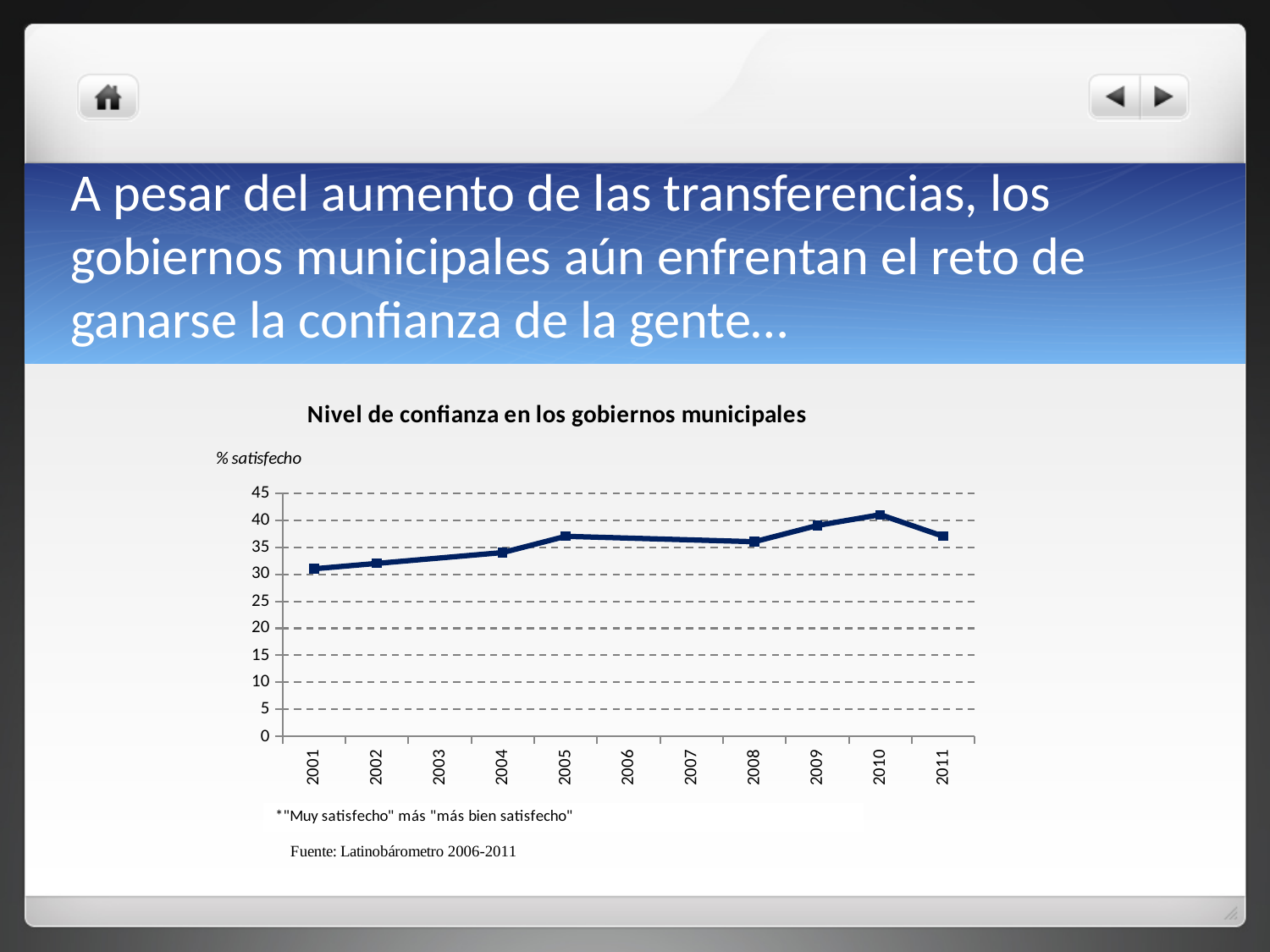
Is the value for 2001 greater or less than 35? less Is the value for 2009 greater or less than 35? greater What is the title of the chart? Nivel de confianza en los gobiernos municipales Which year has the larger value, 2010 or 2011? 2010 In which year is the level of confidence highest? 2010 What kind of chart is shown on the slide? line chart Is the value for 2010 greater or less than 35? greater Which year has the larger value, 2001 or 2005? 2005 What label is shown on the vertical axis of the chart? % satisfecho Does the level of confidence rise or fall between 2010 and 2011? fall How many years are shown on the x axis of the chart? 11